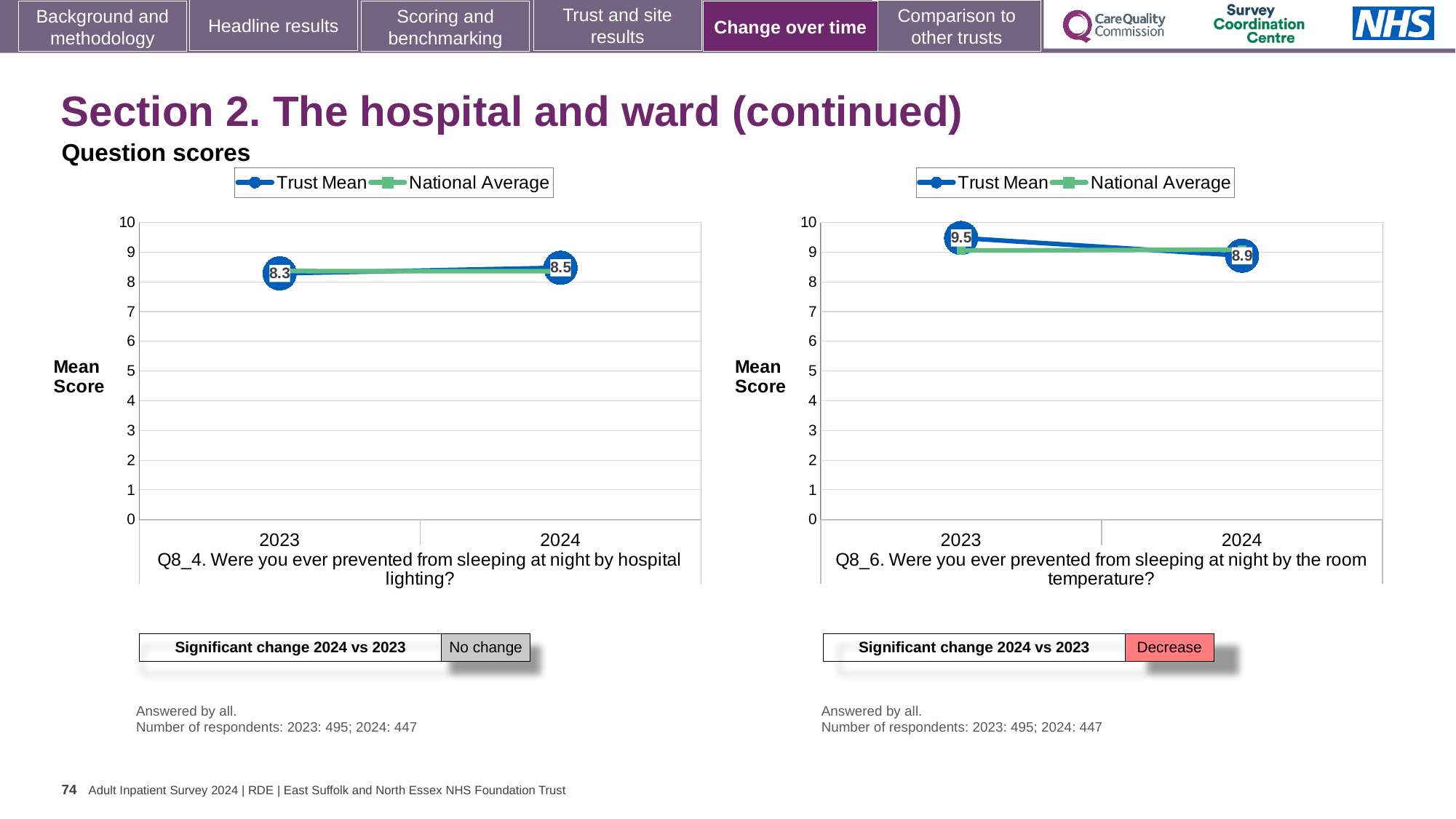
On the right chart (Q8_6, room temperature), does the Trust Mean rise or fall from 2023 to 2024? fall On the left chart (Q8_4, hospital lighting), what is the Trust Mean score for 2023? 8.3 How many series does the legend of the left chart list? 2 On the left chart (Q8_4, hospital lighting), does the Trust Mean rise or fall from 2023 to 2024? rise On the left chart (Q8_4, hospital lighting), what is the Trust Mean score for 2024? 8.5 On the left chart (Q8_4, hospital lighting), what is the difference between the Trust Mean for 2024 and 2023? 0.2 What does the 'Significant change 2024 vs 2023' box below the right chart (Q8_6) say? Decrease On the right chart (Q8_6, room temperature), what is the Trust Mean score for 2024? 8.9 On the right chart (Q8_6, room temperature), what is the Trust Mean score for 2023? 9.5 What kind of chart is the right chart (Q8_6, room temperature)? line chart On the right chart (Q8_6, room temperature), which year has the higher Trust Mean, 2023 or 2024? 2023 On the right chart (Q8_6, room temperature), by how much did the Trust Mean change from 2023 to 2024? 0.6